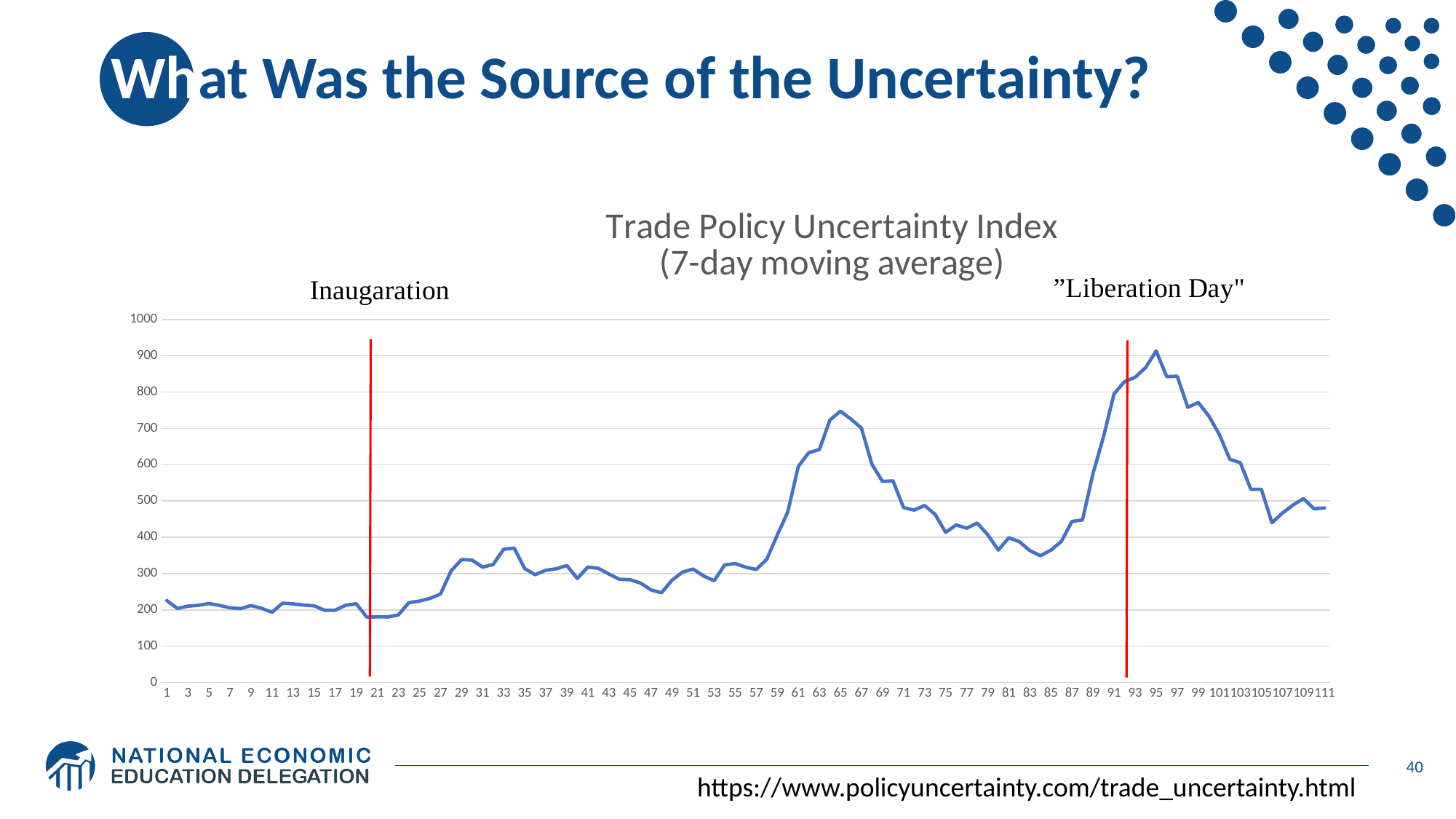
Which is larger, the value at point 95 or the value at point 65? point 95 Is the value of the Trade Policy Uncertainty Index at point 1 greater or less than 300? less Is the value of the Trade Policy Uncertainty Index at point 111 greater or less than 600? less What two events are marked by the red vertical lines on the chart? Inaugaration and "Liberation Day" Does the Trade Policy Uncertainty Index rise or fall between point 85 and point 95? rise What is the title of the chart? Trade Policy Uncertainty Index (7-day moving average) Does the Trade Policy Uncertainty Index rise or fall between point 95 and point 107? fall Is the value of the Trade Policy Uncertainty Index at point 21 greater or less than 300? less What kind of chart is shown on the slide? line chart What is the highest value shown on the vertical axis of the chart? 1000